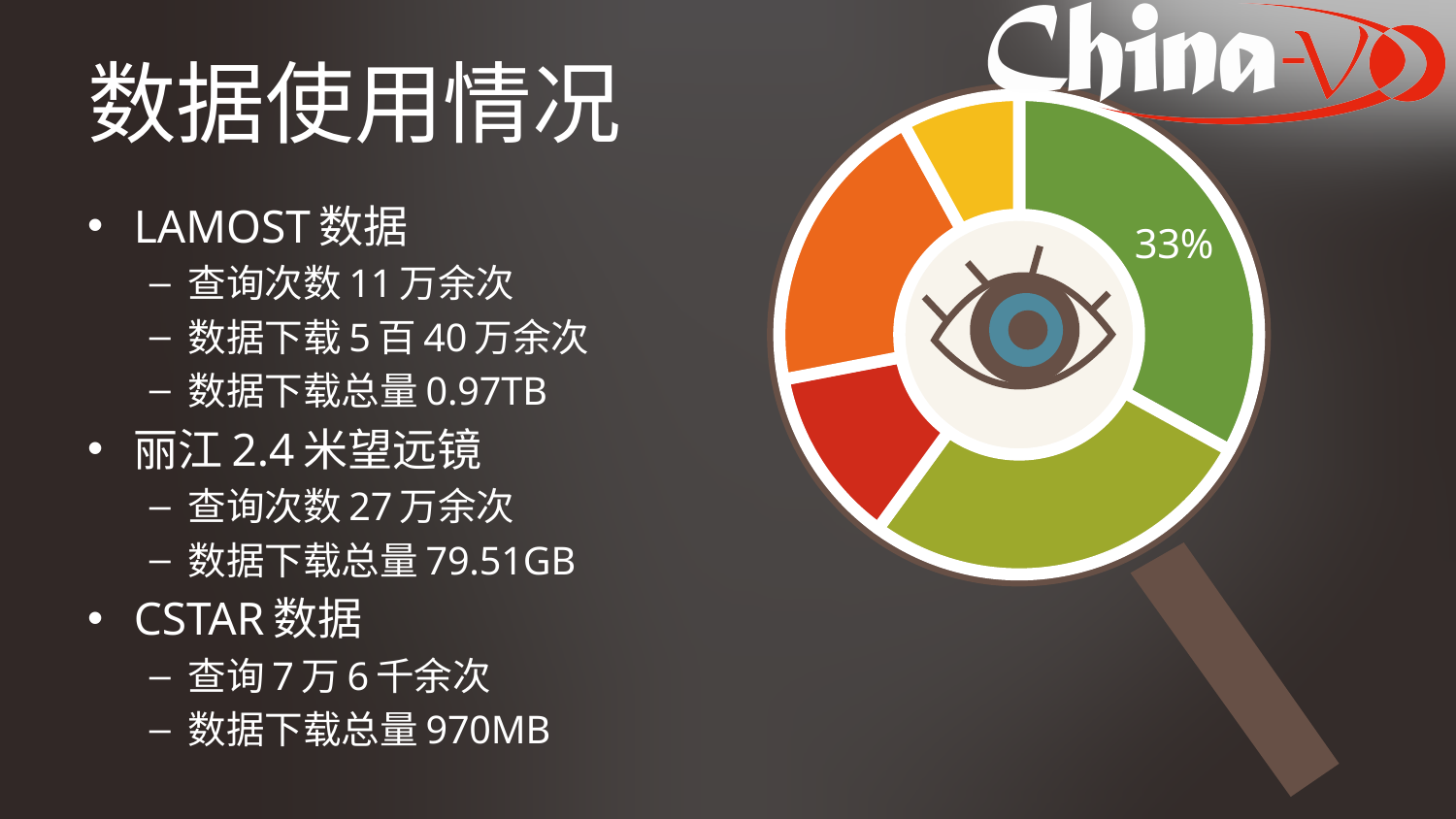
What kind of chart is shown on the right side of the slide? pie chart (donut) What percentage is printed on the dark green slice of the donut chart? 33% Which slice of the donut chart is the largest? the dark green slice How many slices does the donut chart on the right contain? 5 Which is larger in the donut chart, the orange slice or the yellow slice? the orange slice Which is larger in the donut chart, the dark green slice or the yellow slice? the dark green slice How many slices of the donut chart have a percentage label printed on them? 1 What icon is drawn in the centre of the donut chart? an eye What share of the donut chart does the dark green slice represent? 33%